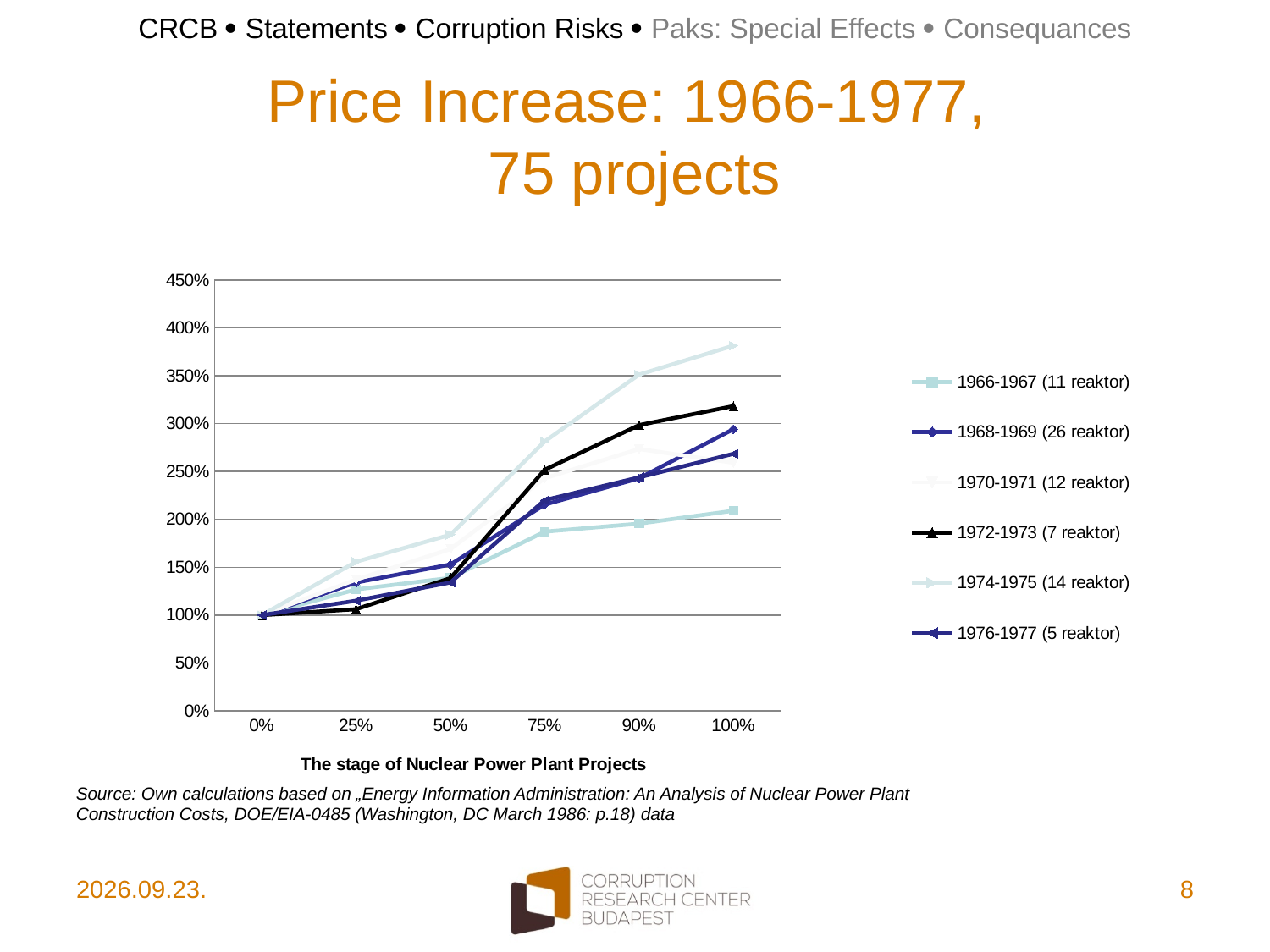
What is the value of the 1966-1967 (11 reaktor) series at the 0% stage? 100% What kind of chart is shown on the slide? line chart Is the value for the 1966-1967 (11 reaktor) series at the 75% stage greater or less than 200%? less How many series does the legend list? 6 What is the title of the x axis? The stage of Nuclear Power Plant Projects How many project-stage categories are shown on the x axis? 6 Is the value for the 1974-1975 (14 reaktor) series at the 100% stage greater or less than 350%? greater Which series has the lowest value at the 100% stage? 1966-1967 (11 reaktor) Which series has the highest value at the 100% stage? 1974-1975 (14 reaktor) At the 100% stage, which is larger: the 1972-1973 (7 reaktor) series or the 1968-1969 (26 reaktor) series? 1972-1973 (7 reaktor) Do the values of the 1972-1973 (7 reaktor) series rise or fall as the project stage increases from 0% to 100%? rise Which legend entry corresponds to 7 reactors? 1972-1973 (7 reaktor)